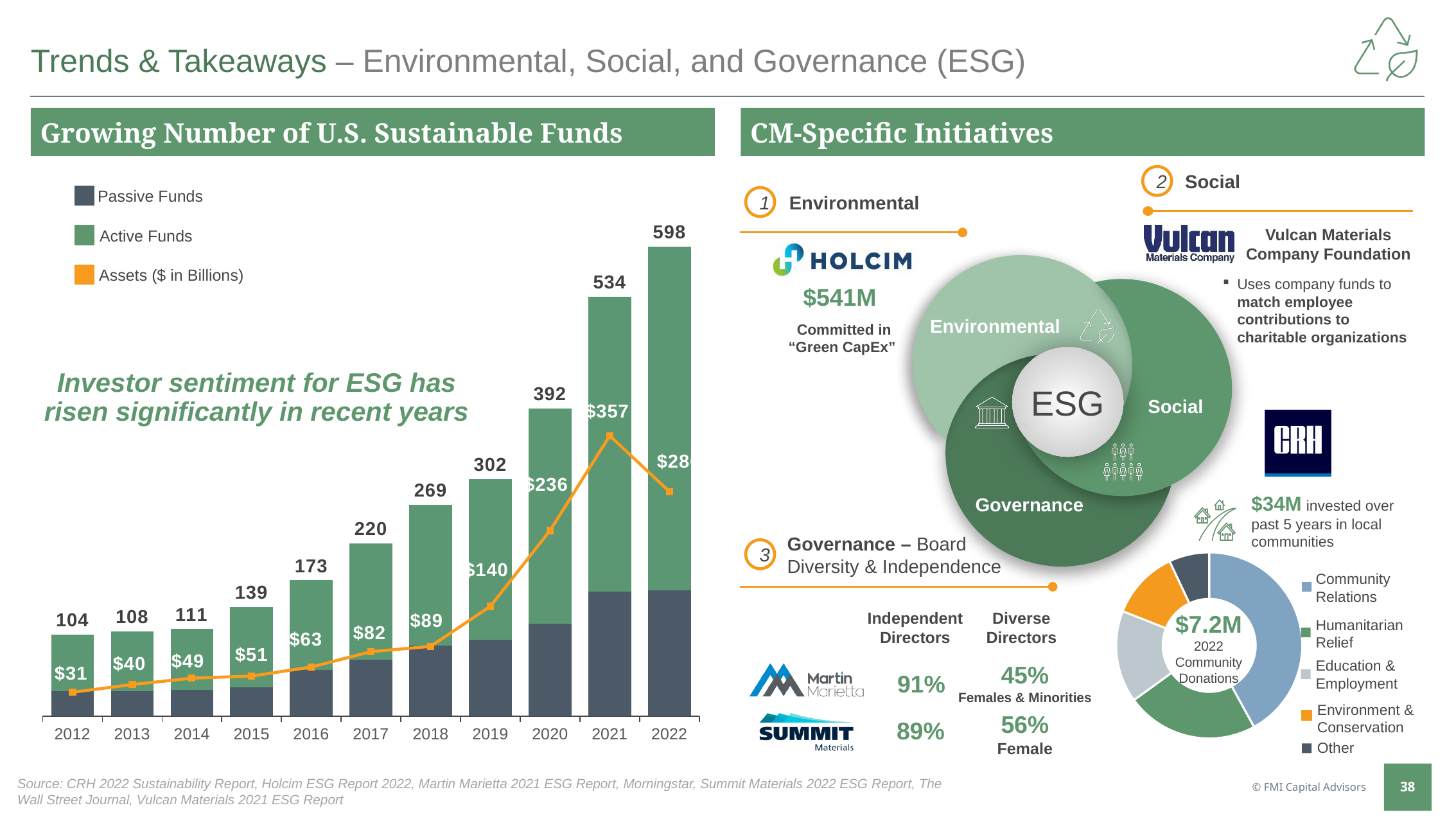
In the 'Growing Number of U.S. Sustainable Funds' chart, which year has the highest total number of funds? 2022 In the 'Growing Number of U.S. Sustainable Funds' chart, does the total number of funds rise or fall from 2012 to 2022? Rise In the 'Growing Number of U.S. Sustainable Funds' chart, by how much did the total number of funds increase from 2021 to 2022? 64 In the '2022 Community Donations' donut chart on the right, which category has the smallest slice? Other In the 'Growing Number of U.S. Sustainable Funds' chart, which year has the larger Assets value, 2018 or 2019? 2019 How many series does the legend of the 'Growing Number of U.S. Sustainable Funds' chart list? 3 In the 'Growing Number of U.S. Sustainable Funds' chart, which year has the lowest total number of funds? 2012 In the 'Growing Number of U.S. Sustainable Funds' chart, what is the Assets value shown for 2021? $357 What kind of chart is 'Growing Number of U.S. Sustainable Funds'? A stacked bar chart combined with a line In the 'Growing Number of U.S. Sustainable Funds' chart, what is the difference between the Assets values for 2021 and 2020? $121 In the 'Growing Number of U.S. Sustainable Funds' chart, what is the total number of funds shown for 2022? 598 How many years are shown on the x axis of the 'Growing Number of U.S. Sustainable Funds' chart? 11